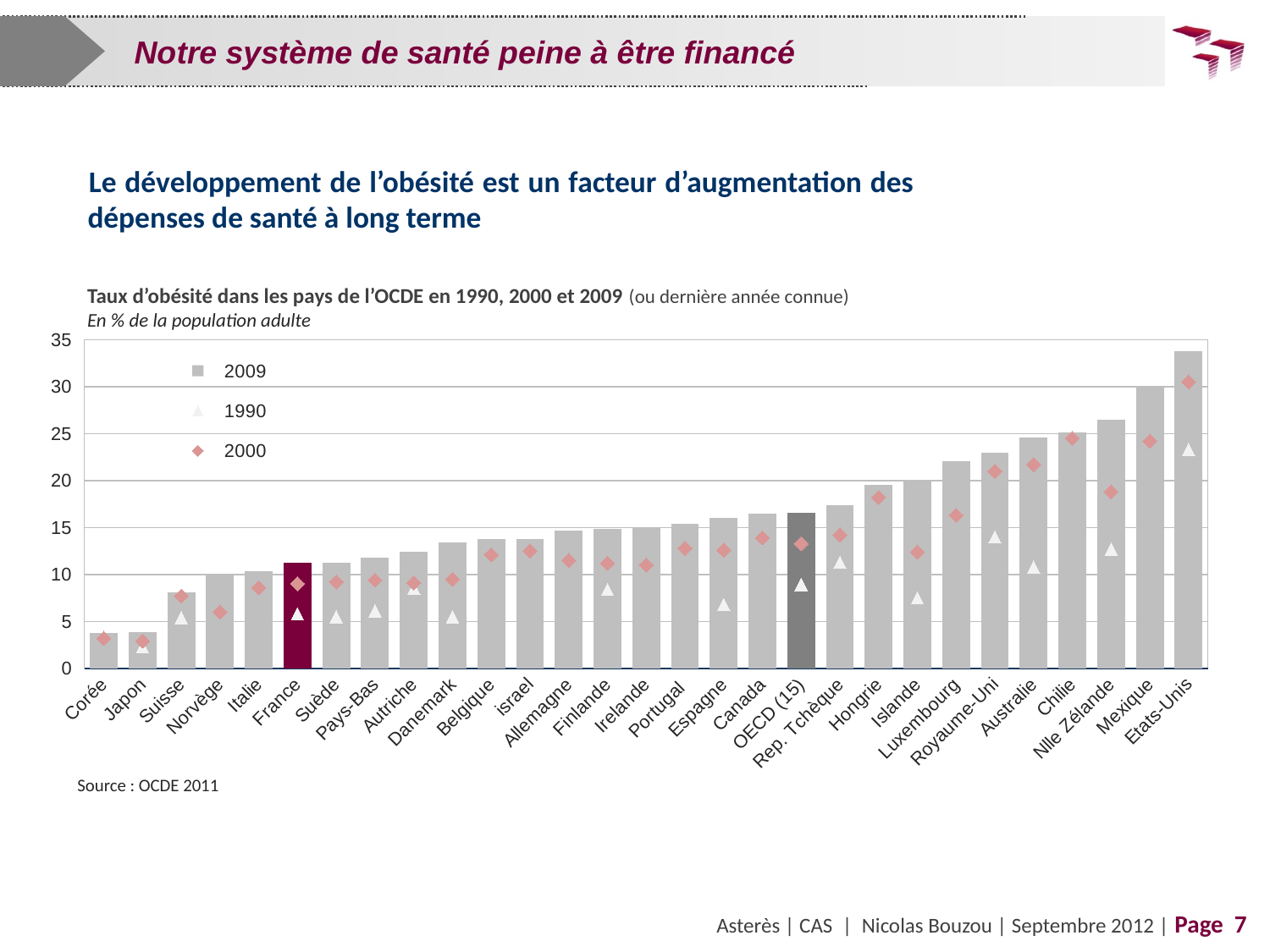
Do the 2009 bars rise or fall from left to right along the x axis? rise Is the 2009 value for France greater or less than 15? less How many series does the legend list? 3 Is the 2009 value for Etats-Unis greater or less than 30? greater What kind of chart is shown on the slide? bar chart Is the 2009 value for Hongrie greater or less than 15? greater Which country has the highest 2009 obesity rate bar? Etats-Unis Which has the larger 2009 bar, Etats-Unis or Mexique? Etats-Unis Which has the larger 2009 bar, France or Allemagne? Allemagne What source is cited below the chart? OCDE 2011